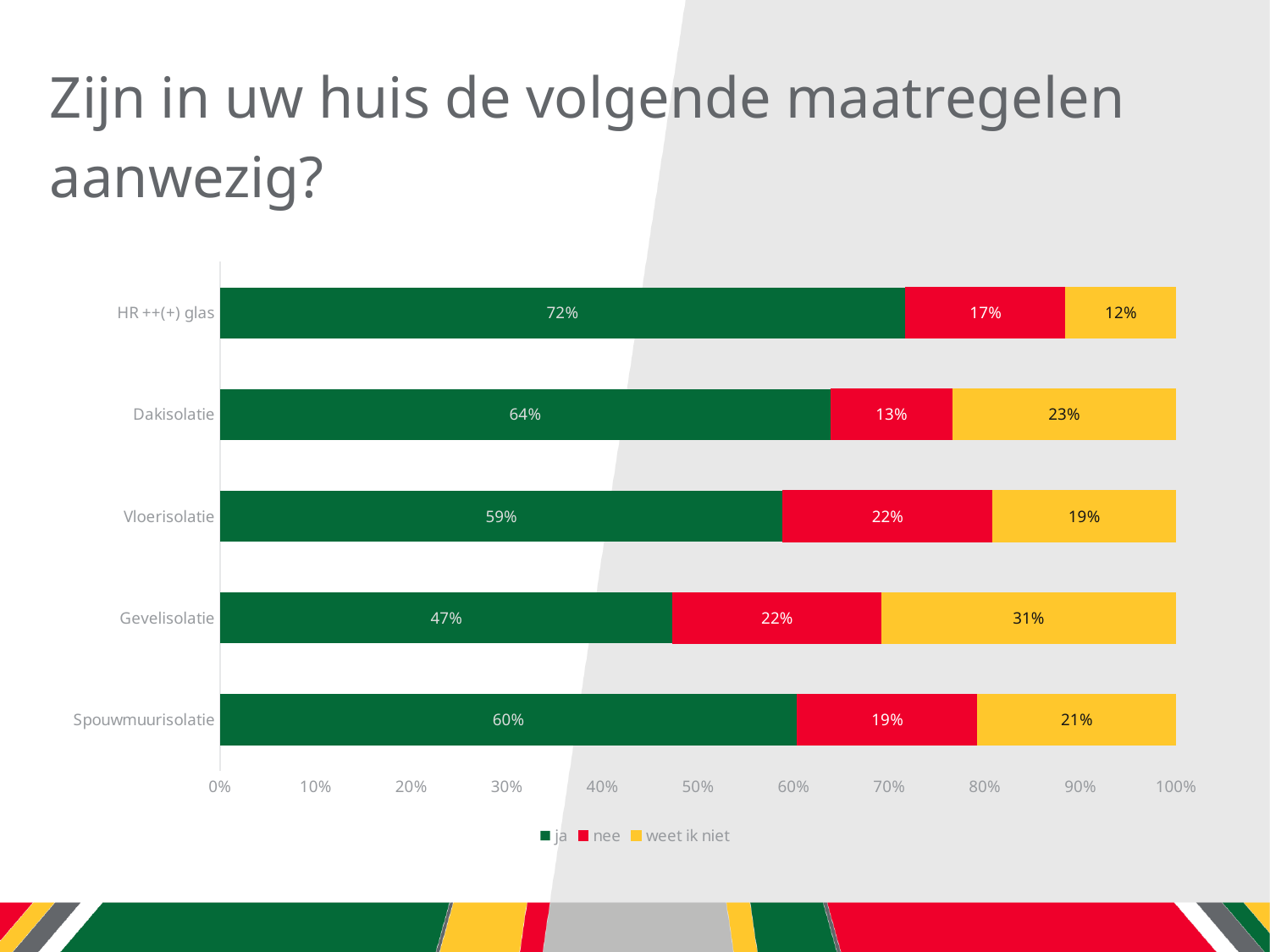
What is the difference between the 'ja' values for Dakisolatie and Spouwmuurisolatie? 4% What is the 'nee' value for Dakisolatie? 13% What is the 'weet ik niet' value for Gevelisolatie? 31% What kind of chart is shown on the slide? Stacked bar chart Which category has the lowest 'ja' value? Gevelisolatie Which colour represents the 'nee' series in the legend? Red How many categories are shown on the chart? 5 Which is larger: the 'weet ik niet' value for Dakisolatie or for Vloerisolatie? Dakisolatie What is the 'ja' value for HR ++(+) glas? 72% How many series does the legend list? 3 Which category has the highest 'ja' value? HR ++(+) glas What is the total of the stacked bar for Vloerisolatie? 100%